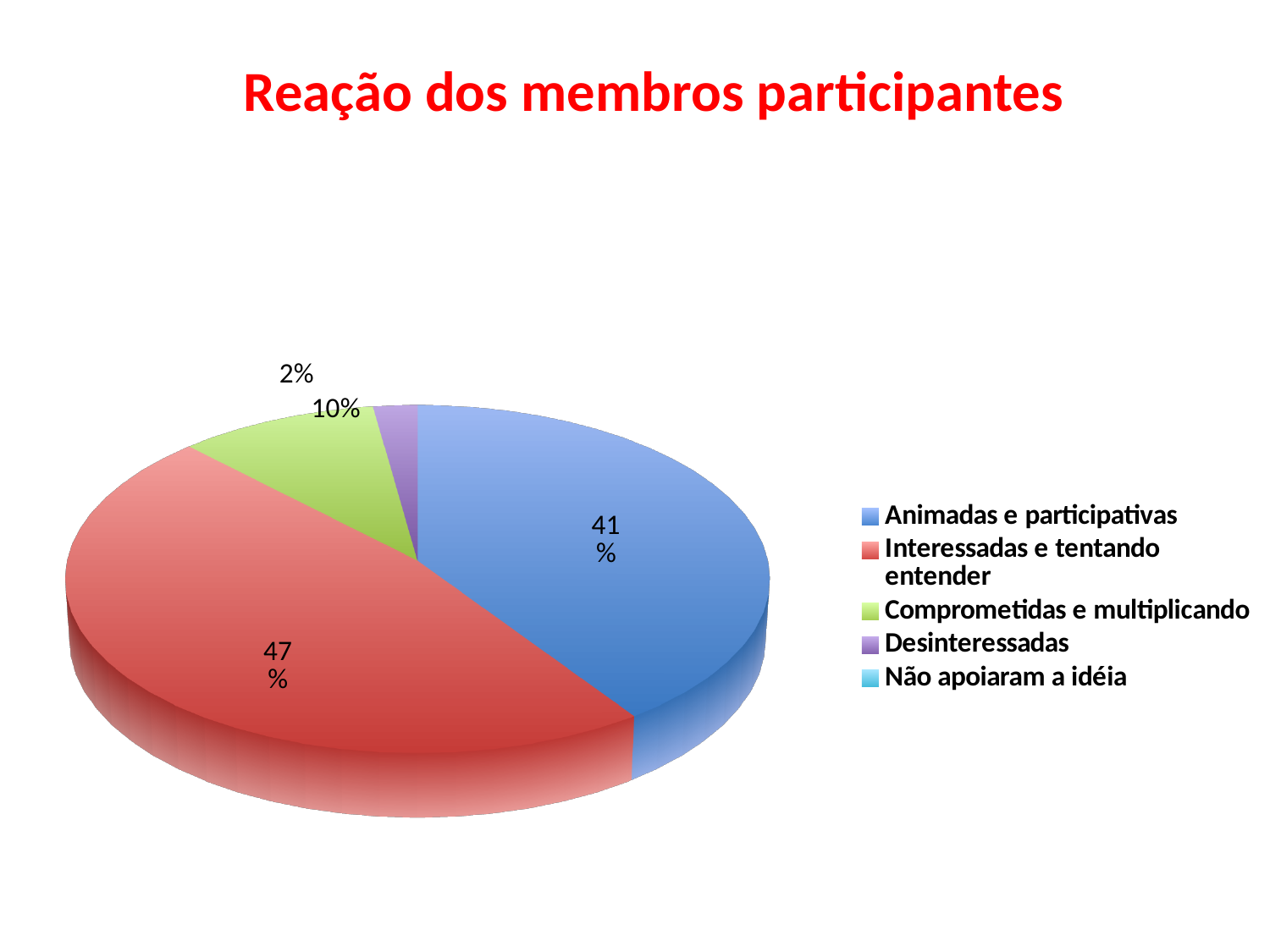
How many entries does the legend list? 5 What is the title of the chart? Reação dos membros participantes Which is larger: the slice for 'Animadas e participativas' or the slice for 'Comprometidas e multiplicando'? Animadas e participativas Which category has the smallest printed percentage on the pie? Desinteressadas What percentage is shown for 'Comprometidas e multiplicando'? 10% What percentage is shown for 'Interessadas e tentando entender'? 47% What is the difference in percentage points between 'Interessadas e tentando entender' and 'Animadas e participativas'? 6 percentage points What kind of chart is shown on the slide? Pie chart What percentage of the pie is labelled for 'Animadas e participativas'? 41% What is the difference in percentage points between 'Comprometidas e multiplicando' and 'Desinteressadas'? 8 percentage points What percentage is shown for 'Desinteressadas'? 2% Which category has the largest slice of the pie? Interessadas e tentando entender